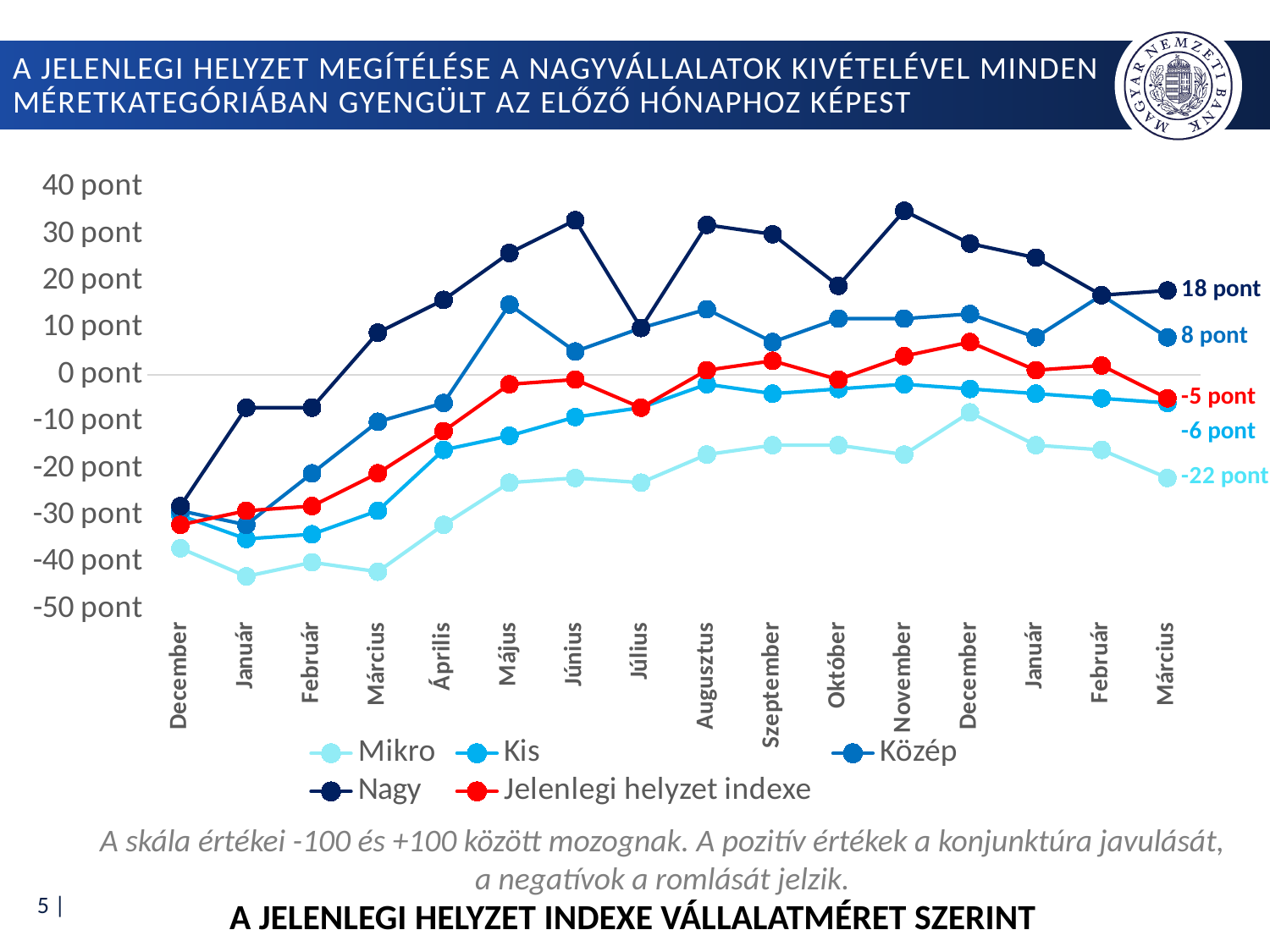
What is the value of the Mikro series at the final Március point? -22 pont Which series has the highest value at the final Március point? Nagy What is the difference between the Nagy and Közép values at the final Március point? 10 pont At the final Március point, which is larger: the Kis value or the Mikro value? Kis How many series does the legend list? 5 What is the title of the chart shown at the bottom of the slide? A JELENLEGI HELYZET INDEXE VÁLLALATMÉRET SZERINT What is the value of the Nagy series at the final Március point? 18 pont Is the value for the Nagy series in November greater or less than 30 pont? greater What is the value of the Jelenlegi helyzet indexe series at the final Március point? -5 pont What kind of chart is shown on the slide? line chart What is the value of the Közép series at the final Március point? 8 pont How many months are plotted along the x axis? 16